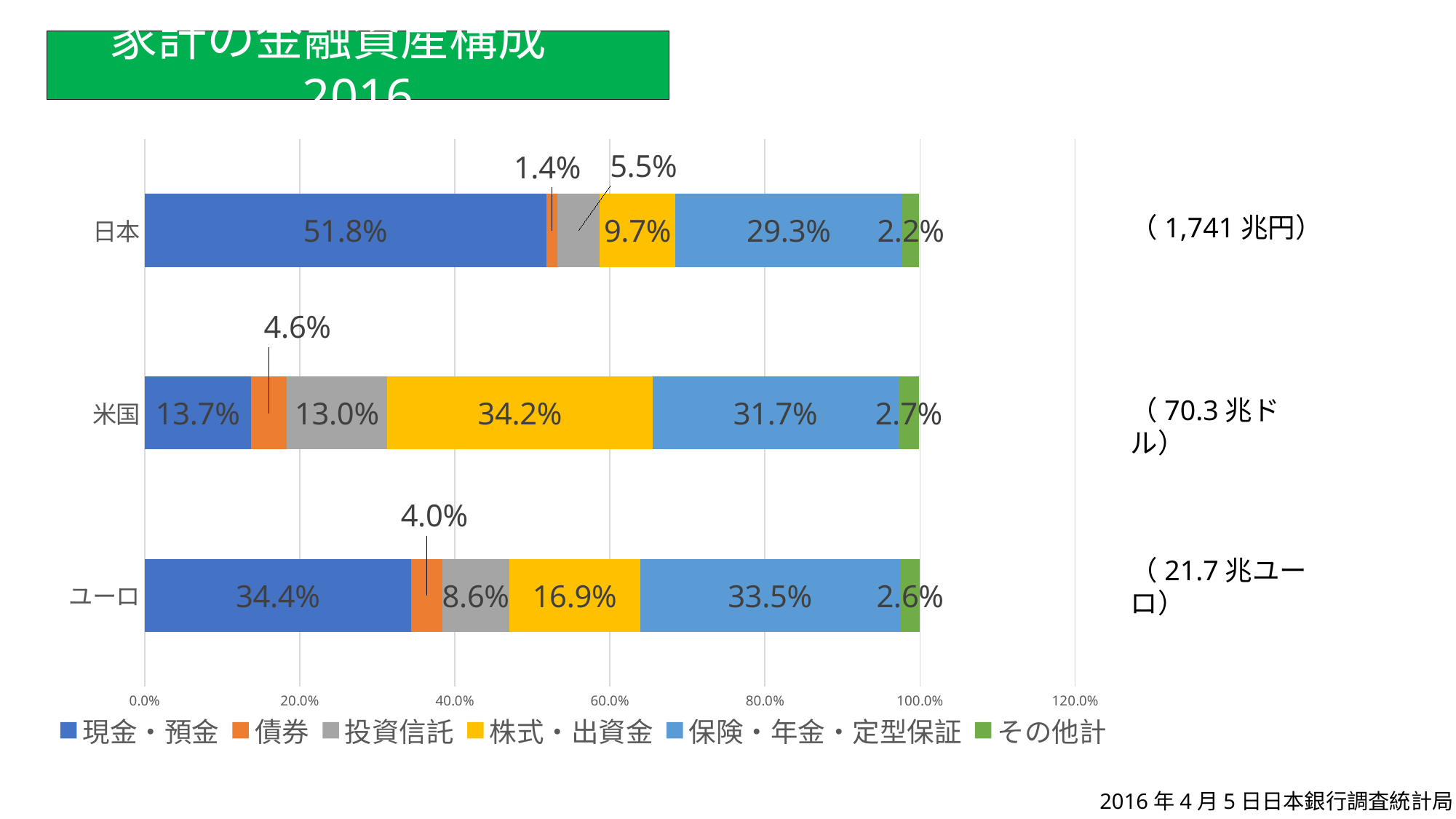
Which is larger, the 保険・年金・定型保証 share for 米国 or for ユーロ? ユーロ What is the 保険・年金・定型保証 share for ユーロ? 33.5% What is the 債券 share for 日本? 1.4% What is the 投資信託 share for 米国? 13.0% How many categories are shown on the chart? 3 How many series does the legend list? 6 What is the difference between the 現金・預金 share of 日本 and that of 米国? 38.1% Which category has the lowest 株式・出資金 share? 日本 What kind of chart is shown on the slide? Stacked bar chart What is the 現金・預金 share for 日本? 51.8% Which category has the highest 現金・預金 share? 日本 What is the 株式・出資金 share for 米国? 34.2%